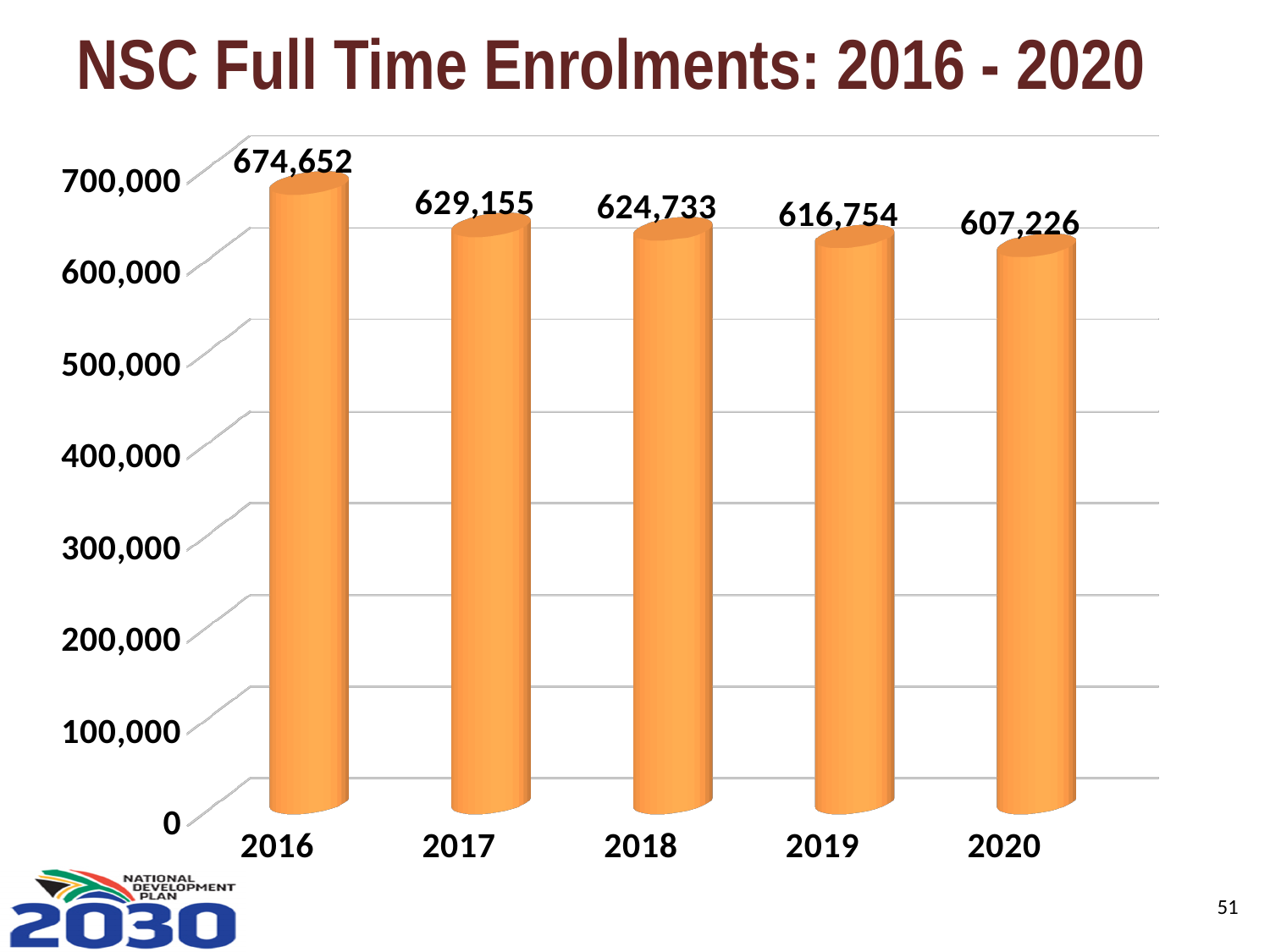
Which year has the lowest enrolment? 2020 What is the difference between the 2019 and 2020 enrolment values? 9,528 Do the enrolment values rise or fall from 2016 to 2020? fall Which year has the highest enrolment? 2016 What is the NSC full time enrolment value for 2016? 674,652 Is the value for 2016 greater or less than 600,000? greater What is the NSC full time enrolment value for 2020? 607,226 How many years are shown on the x axis? 5 What kind of chart is shown on the slide? bar chart Which is larger, the value for 2017 or the value for 2019? 2017 What is the difference between the 2016 and 2017 enrolment values? 45,497 What is the value shown for 2018? 624,733